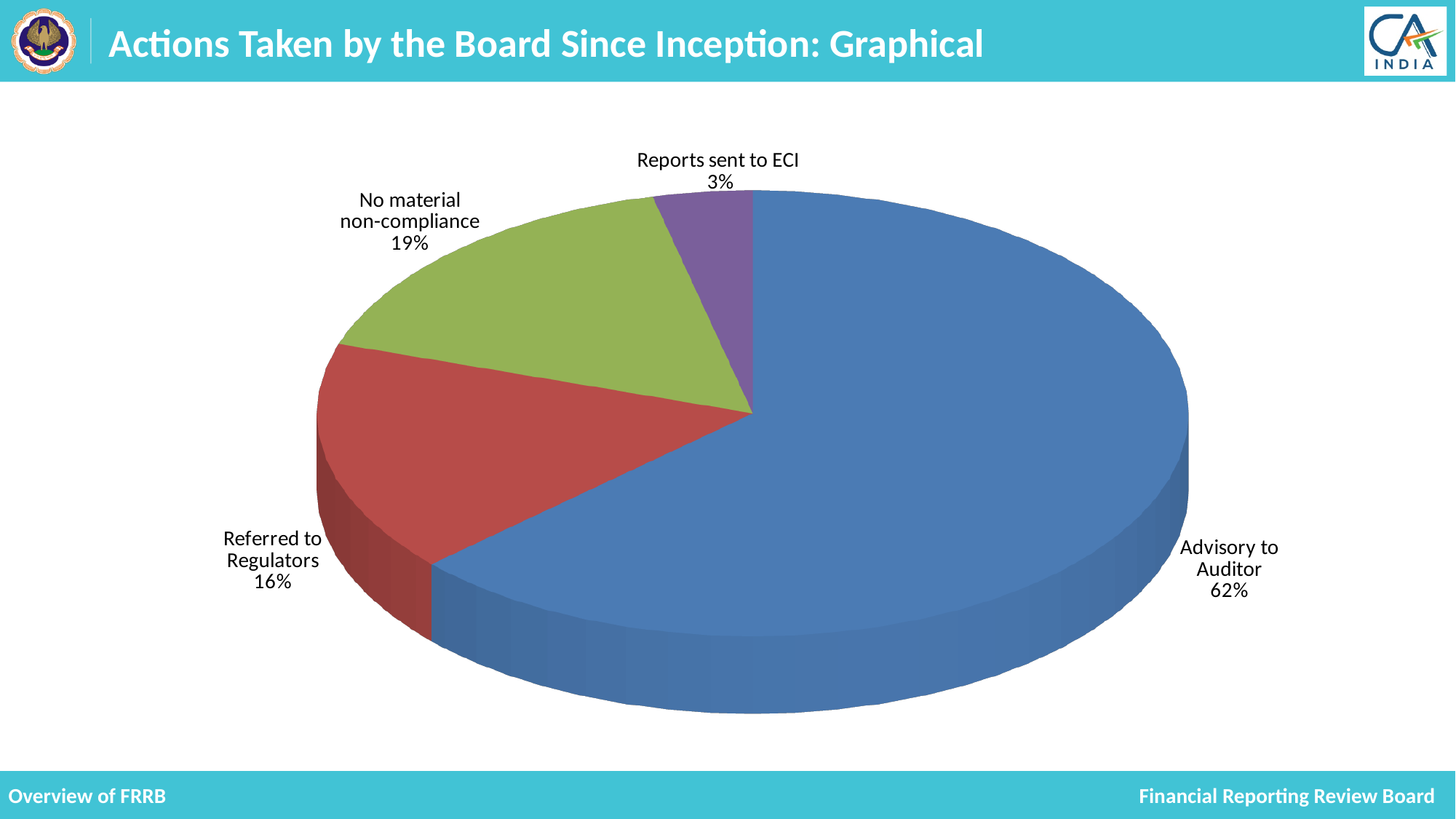
What is the difference in percentage points between Referred to Regulators and Reports sent to ECI? 13 What share of the pie is labelled Reports sent to ECI? 3% What colour is the Advisory to Auditor slice? Blue What share of the pie is labelled Referred to Regulators? 16% What share of the pie is labelled No material non-compliance? 19% What kind of chart is shown on the slide? Pie chart How many slices does the pie chart have? 4 Which category has the smallest slice of the pie? Reports sent to ECI Which is larger, the share for No material non-compliance or the share for Referred to Regulators? No material non-compliance What is the difference in percentage points between Advisory to Auditor and No material non-compliance? 43 Which category has the largest slice of the pie? Advisory to Auditor